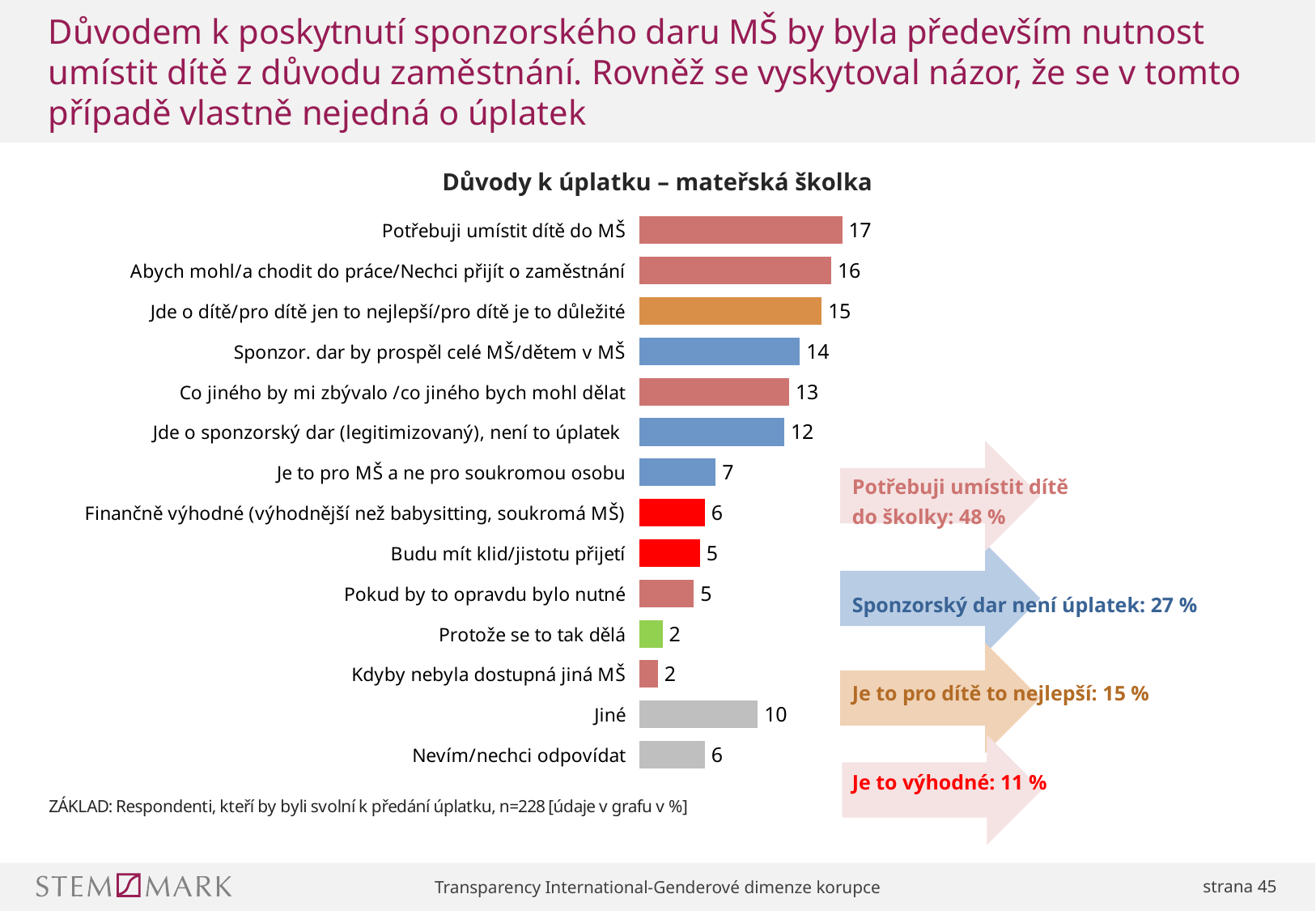
What is the title of the chart? Důvody k úplatku – mateřská školka What is the difference between the values for "Potřebuji umístit dítě do MŠ" and "Abych mohl/a chodit do práce/Nechci přijít o zaměstnání"? 1 What percentage is given in the blue arrow for "Sponzorský dar není úplatek"? 27 % What is the value for "Protože se to tak dělá"? 2 What is the difference between the values for "Jiné" and "Nevím/nechci odpovídat"? 4 Which is larger: the value for "Jiné" or the value for "Je to pro MŠ a ne pro soukromou osobu"? Jiné What is the value for "Jde o sponzorský dar (legitimizovaný), není to úplatek"? 12 What kind of chart is shown on the slide? Bar chart What is the value for "Jiné"? 10 How many categories are shown in the chart? 14 Which category has the highest value? Potřebuji umístit dítě do MŠ What is the value for "Potřebuji umístit dítě do MŠ"? 17